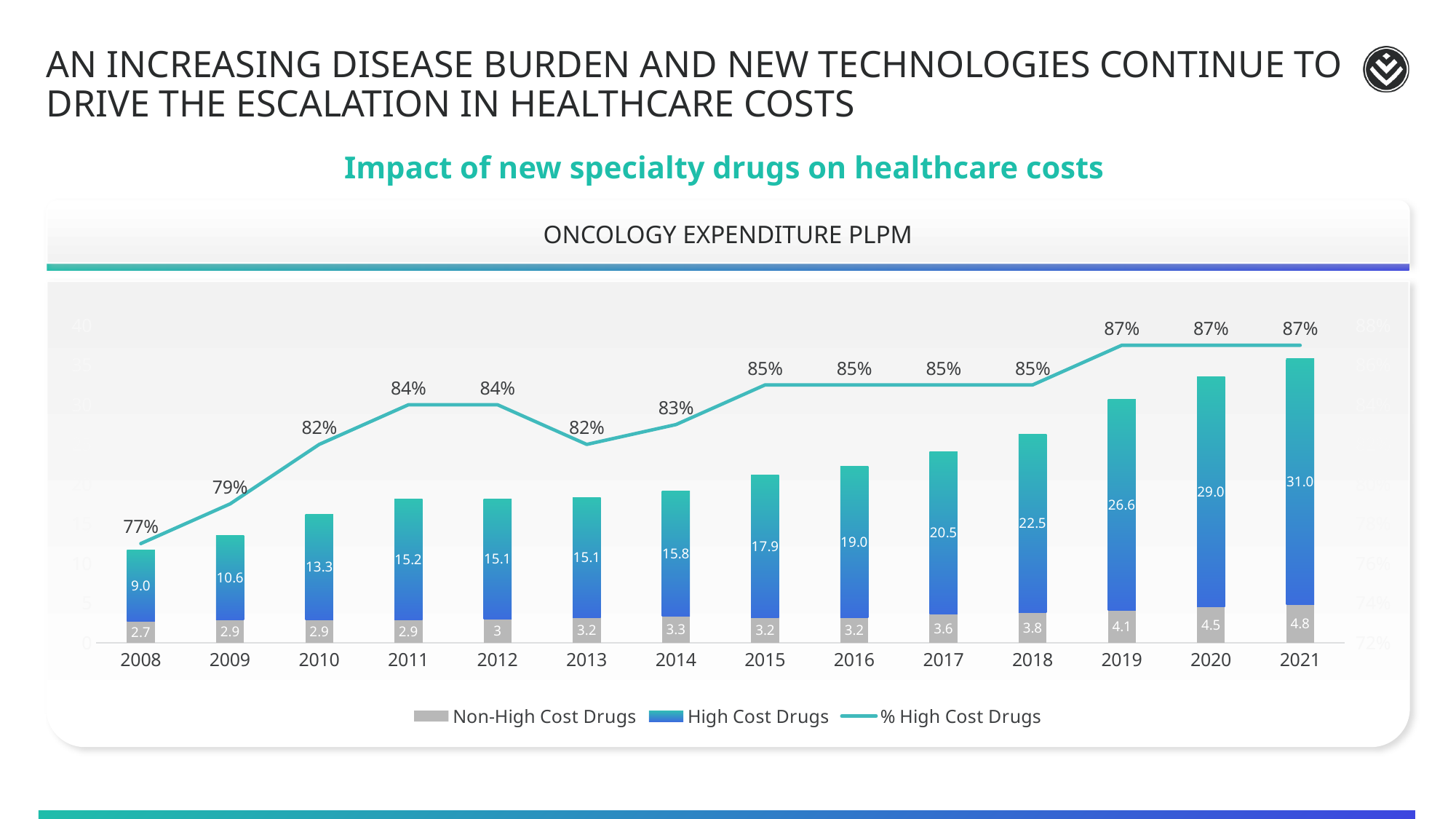
What is the Non-High Cost Drugs value for 2008? 2.7 What is the High Cost Drugs value for 2021? 31.0 What kind of chart is used for the Non-High Cost Drugs and High Cost Drugs series? Stacked bar chart What is the difference between the High Cost Drugs values for 2020 and 2019? 2.4 Which year has the highest High Cost Drugs value? 2021 How many series does the legend list? 3 What is the % High Cost Drugs value for 2013? 82% What is the title of the chart? ONCOLOGY EXPENDITURE PLPM How many years are shown on the x axis? 14 Which is larger, the High Cost Drugs value for 2011 or for 2012? 2011 Which year has the lowest Non-High Cost Drugs value? 2008 What is the total of the stacked bar for 2021? 35.8